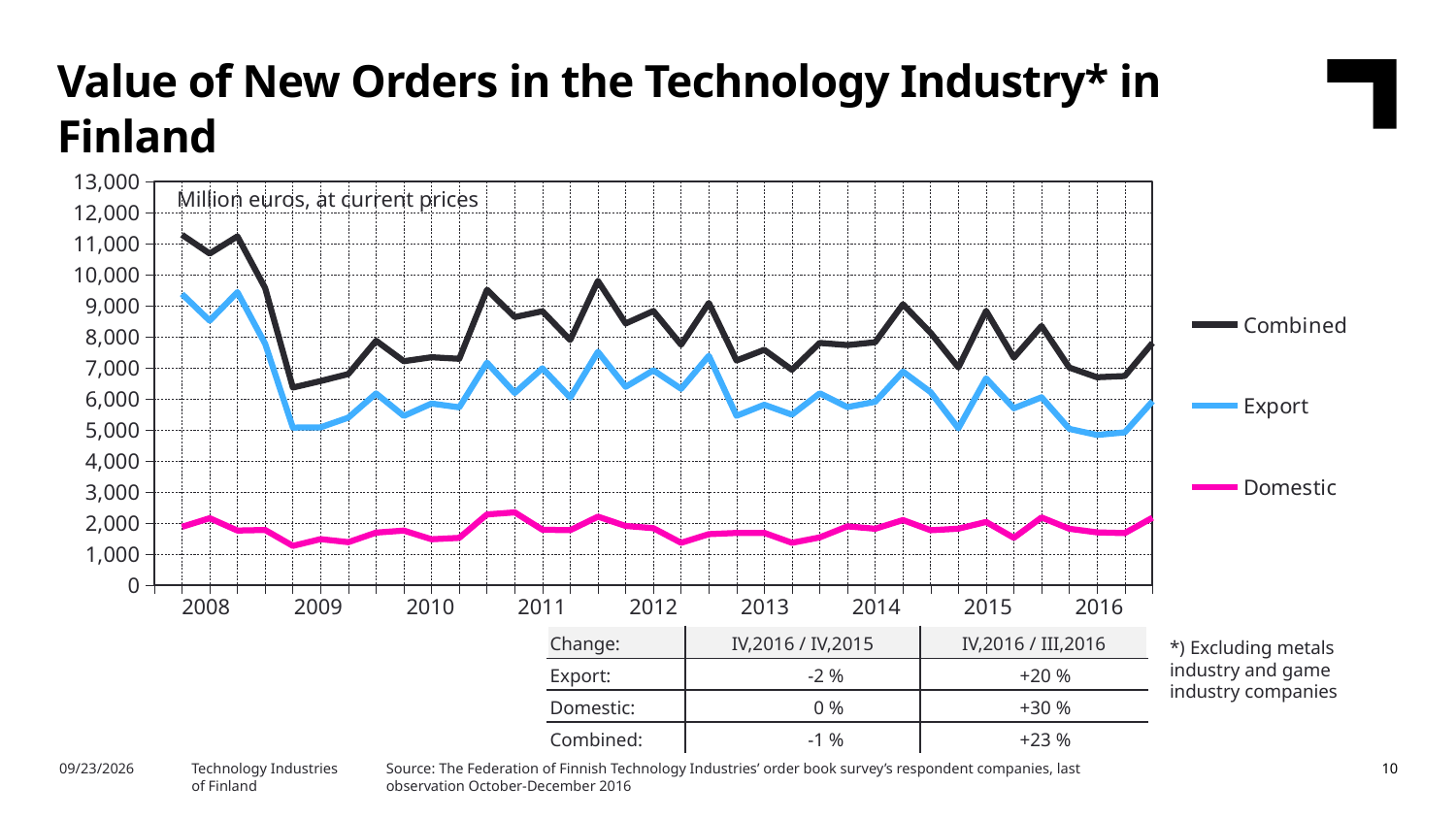
Which series has higher values throughout the chart, Combined or Export? Combined Is the value for Combined at the end of 2016 greater or less than 7,000? greater Is the value for Export at the start of 2008 greater or less than 9,000? greater Is the value for Combined at the start of 2008 greater or less than 11,000? greater Which series is shown in black in the legend? Combined How many series does the legend list? 3 Which series has lower values throughout the chart, Export or Domestic? Domestic Does the Combined series overall rise or fall from 2008 to 2016? fall What kind of chart is shown on the slide? line chart What unit is stated in the label inside the chart area? Million euros, at current prices